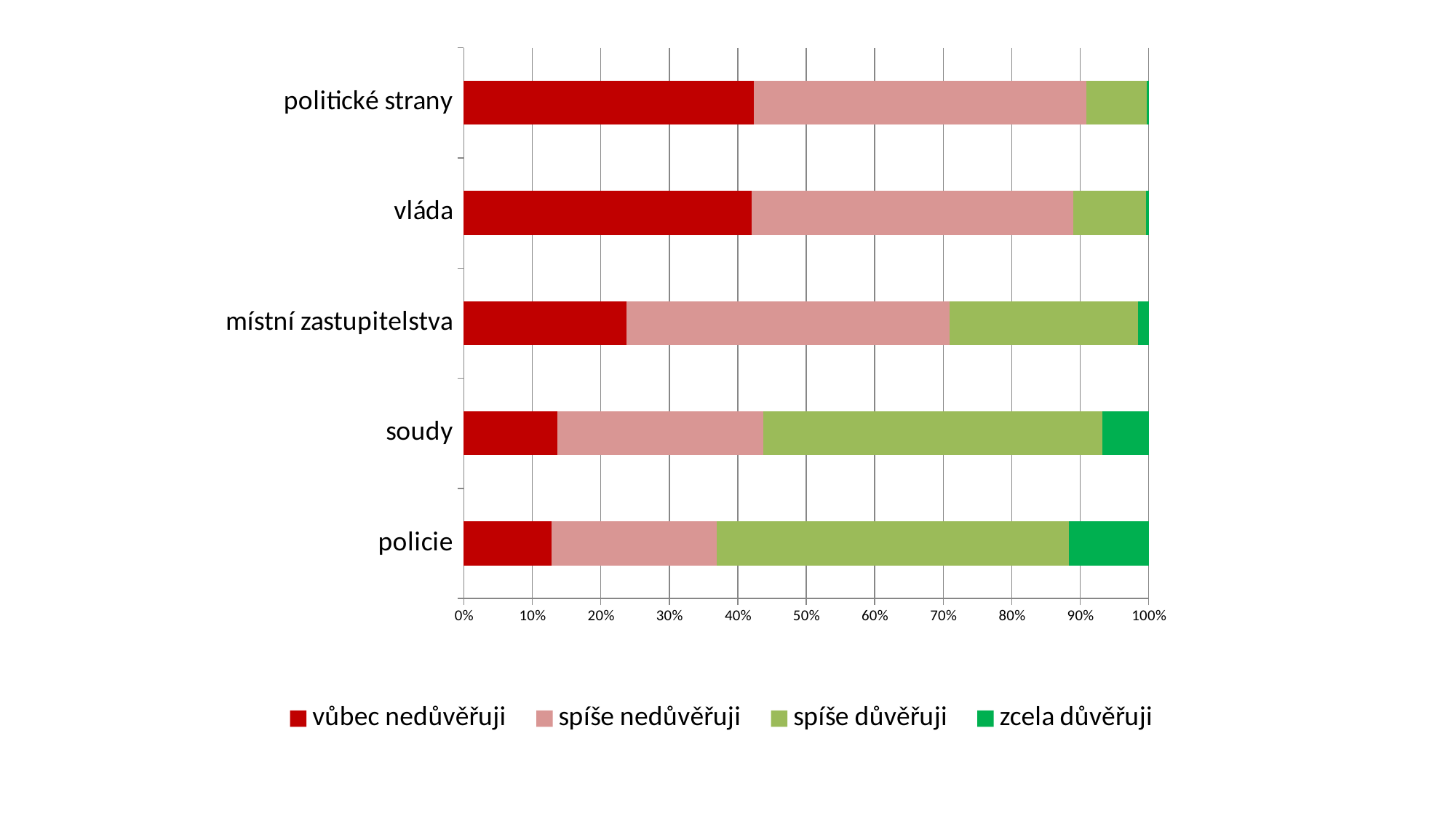
Which category has the largest 'zcela důvěřuji' segment? policie Is the 'vůbec nedůvěřuji' value for politické strany greater or less than 30%? greater Which is larger: the 'vůbec nedůvěřuji' value for politické strany or for policie? politické strany Is the 'vůbec nedůvěřuji' value for soudy greater or less than 20%? less Which is larger: the 'zcela důvěřuji' value for soudy or for vláda? soudy What kind of chart is shown on the slide? stacked bar chart Is the 'vůbec nedůvěřuji' value for místní zastupitelstva greater or less than 30%? less How many categories (institutions) are plotted on the chart? 5 What is the first series listed in the legend? vůbec nedůvěřuji Which is larger: the 'spíše důvěřuji' value for soudy or for politické strany? soudy How many series does the legend list? 4